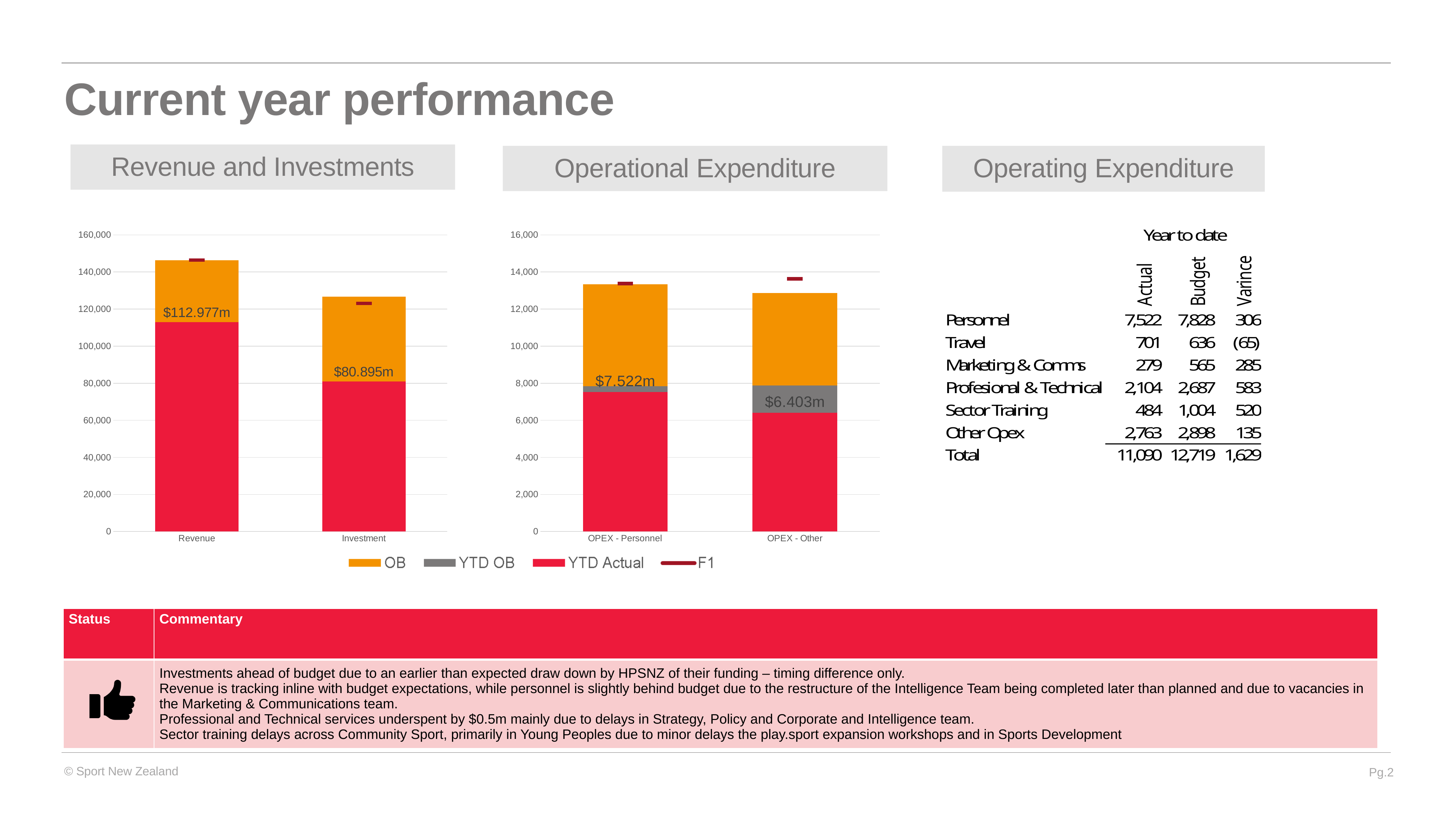
In the Operational Expenditure chart, what is the YTD Actual value labelled on the OPEX - Personnel bar? $7.522m In the Revenue and Investments chart, what is the difference between the labelled YTD Actual values for Revenue and Investment? $32.082m In the Revenue and Investments chart, what is the YTD Actual value labelled on the Revenue bar? $112.977m What kind of chart is the Operational Expenditure chart? Bar chart In the Operational Expenditure chart, which category has the larger labelled YTD Actual value, OPEX - Personnel or OPEX - Other? OPEX - Personnel How many series does the legend below the Operational Expenditure chart list? 4 In the Operational Expenditure chart, what is the YTD Actual value labelled on the OPEX - Other bar? $6.403m How many categories are shown on the x axis of the Revenue and Investments chart? 2 In the legend below the Operational Expenditure chart, what colour represents YTD Actual? Red In the Revenue and Investments chart, is the total height of the Revenue stacked bar greater or less than 140,000? greater In the Revenue and Investments chart, what is the YTD Actual value labelled on the Investment bar? $80.895m In the Operational Expenditure chart, is the total height of the OPEX - Other stacked bar greater or less than 14,000? less